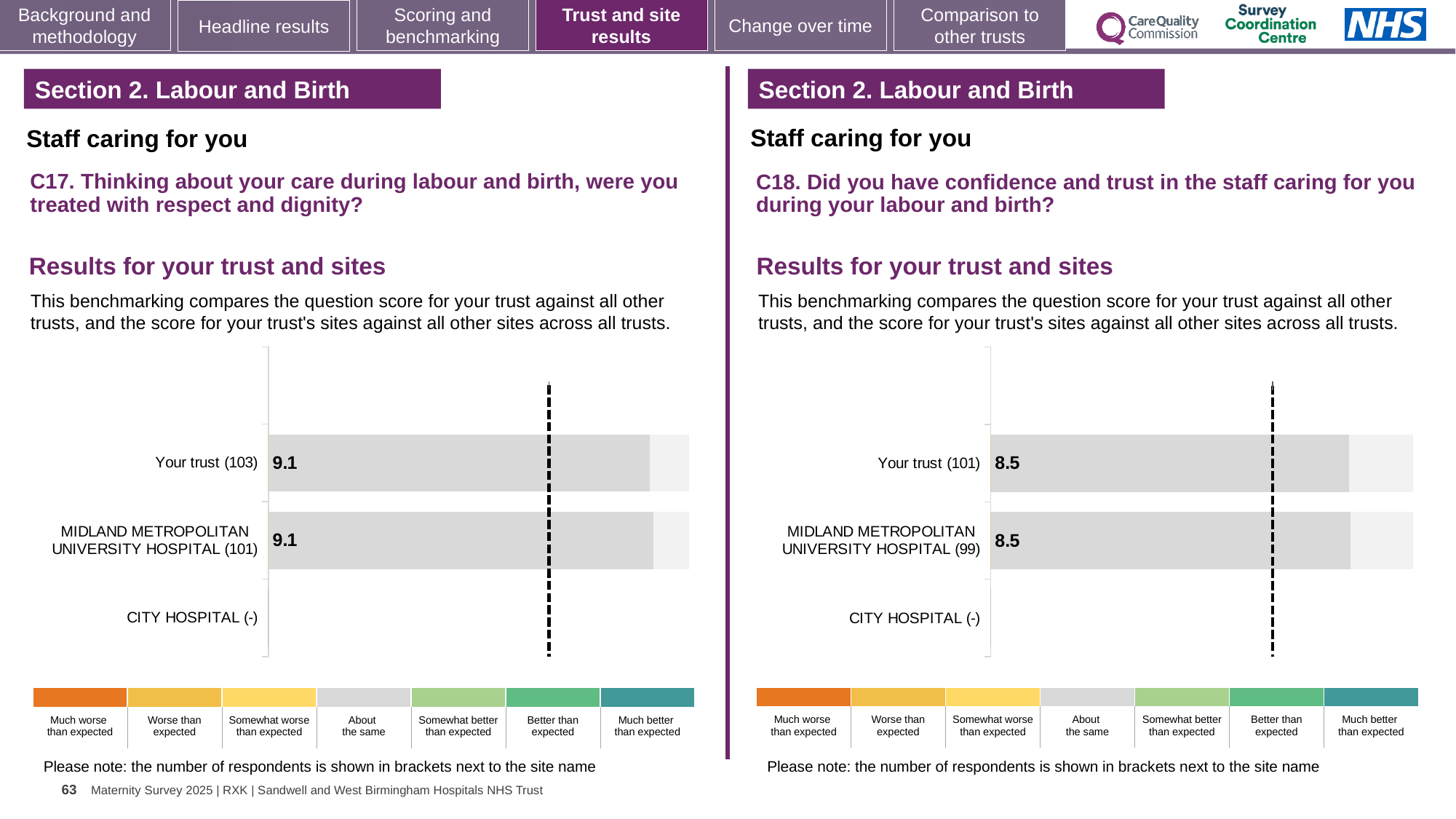
In the C18 chart on the right, what is the score for Your trust (101)? 8.5 In the C17 chart on the left, what is the score for MIDLAND METROPOLITAN UNIVERSITY HOSPITAL (101)? 9.1 How many categories are listed on the vertical axis of the C17 chart on the left? 3 In the C17 chart on the left, which category has no bar plotted? CITY HOSPITAL (-) In the C17 chart on the left, what is the score for Your trust (103)? 9.1 In the C18 chart on the right, what is the difference between the score for Your trust and the score for MIDLAND METROPOLITAN UNIVERSITY HOSPITAL? 0.0 How many categories are listed on the vertical axis of the C18 chart on the right? 3 In the C17 chart on the left, what is the difference between the score for Your trust and the score for MIDLAND METROPOLITAN UNIVERSITY HOSPITAL? 0.0 In the C18 chart on the right, how many respondents are shown in brackets for MIDLAND METROPOLITAN UNIVERSITY HOSPITAL? 99 What kind of chart is the C17 chart on the left? Bar chart In the C18 chart on the right, what is the score for MIDLAND METROPOLITAN UNIVERSITY HOSPITAL (99)? 8.5 How many respondents are shown in brackets for Your trust in the C18 chart on the right? 101